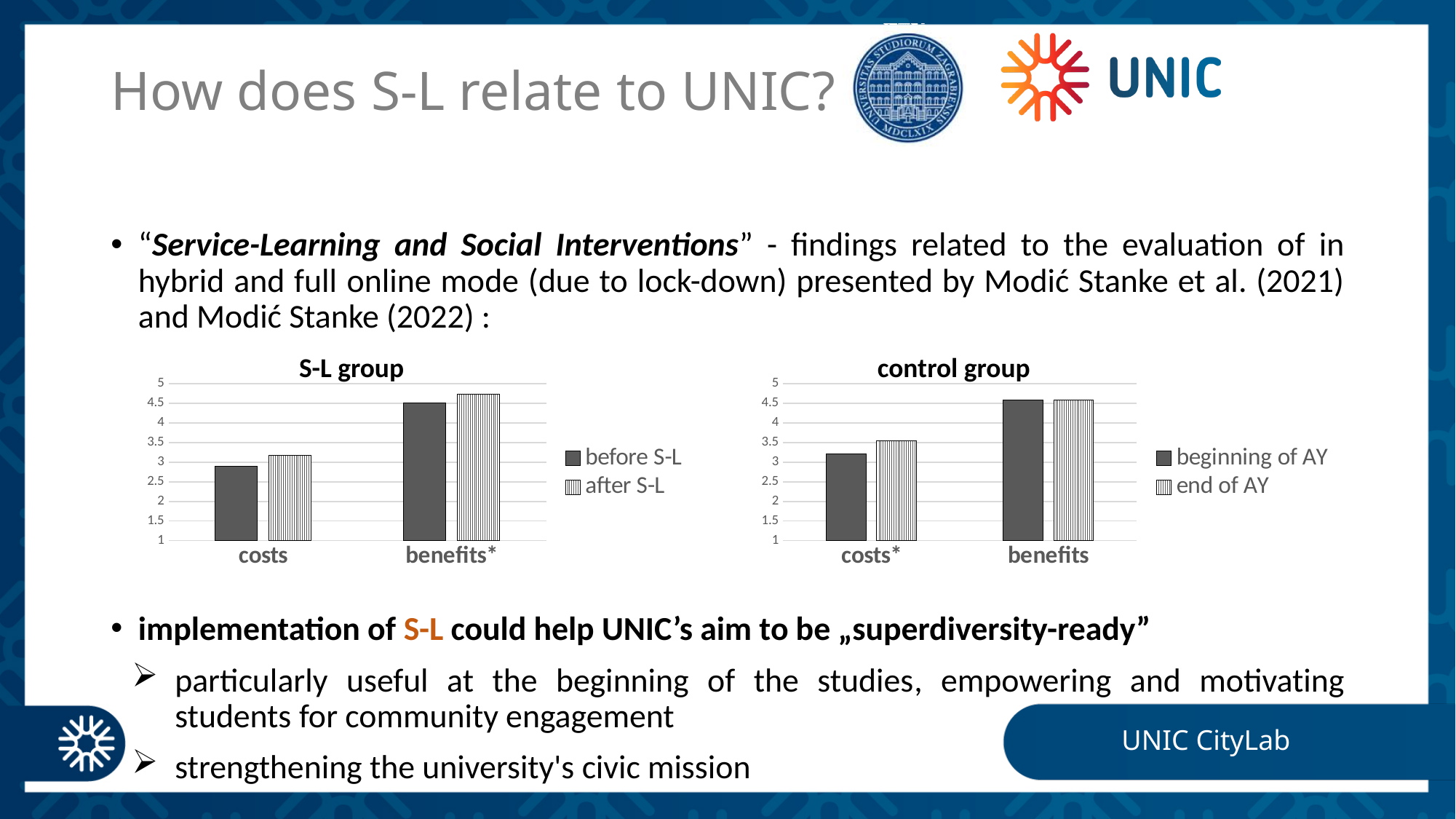
What are the two legend entries of the control group chart? beginning of AY, end of AY In the S-L group chart, is the costs value higher before S-L or after S-L? after S-L In the control group chart, which category has the lower values, costs* or benefits? costs* What kind of chart is the S-L group chart? bar chart In the S-L group chart, is the after S-L value for benefits* greater or less than 4.5? greater In the control group chart, is the beginning of AY value for costs* greater or less than 3? greater How many series does the legend of the S-L group chart list? 2 What is the title of the chart on the left side of the slide? S-L group In the S-L group chart, which category has the higher values, costs or benefits*? benefits* In the S-L group chart, is the after S-L value for costs greater or less than 3? greater How many categories are shown on the x axis of the control group chart? 2